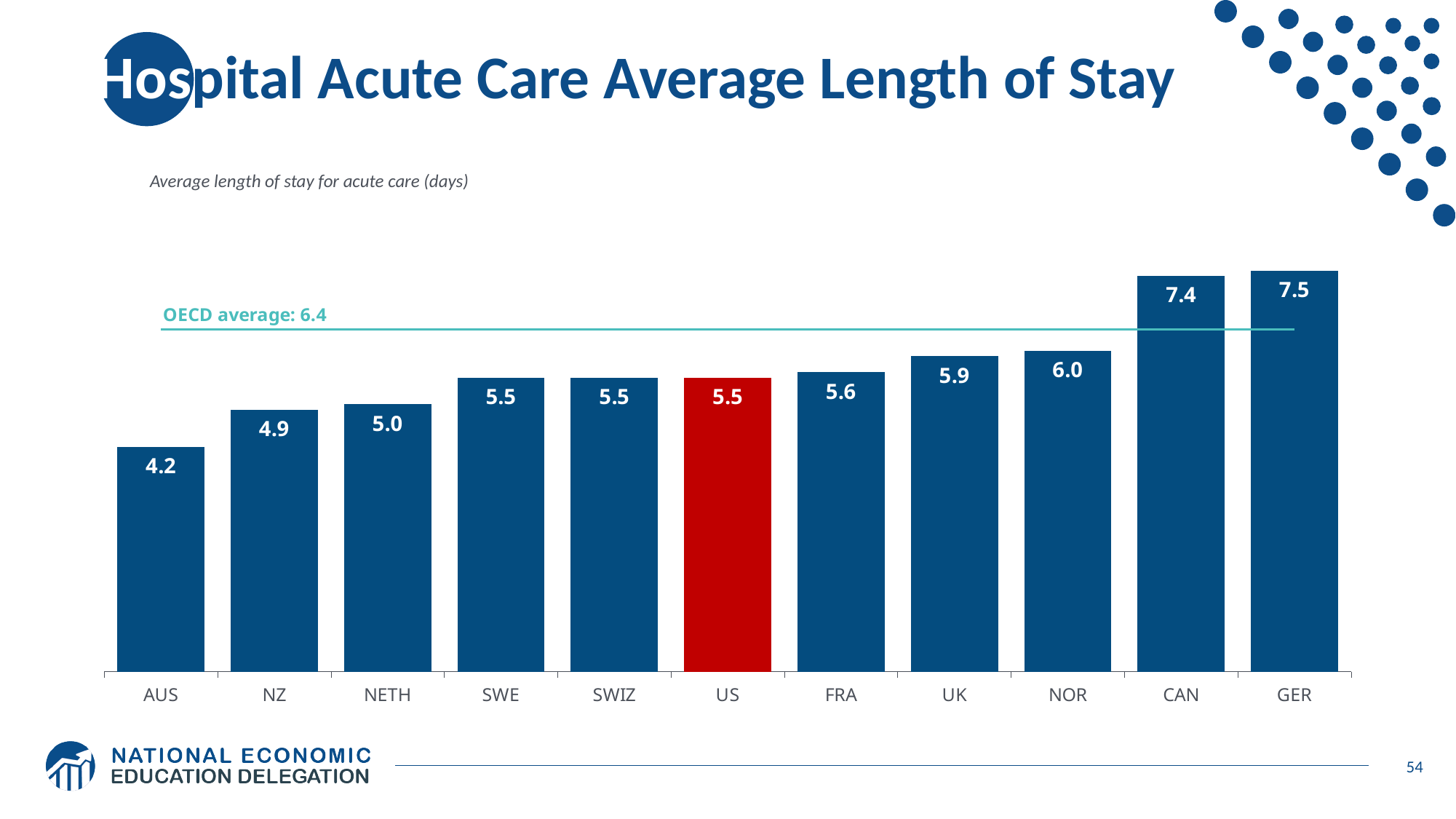
How many countries are shown in the chart? 11 Do the values generally rise or fall from left to right across the countries? Rise What is the average length of stay for acute care in Australia (AUS)? 4.2 Which country has the lowest average length of stay for acute care? AUS What is the average length of stay for acute care in Germany (GER)? 7.5 Which country has the highest average length of stay for acute care? GER What kind of chart is shown on the slide? Bar chart What is the difference in average length of stay between CAN and the US? 1.9 What is the difference in average length of stay between GER and AUS? 3.3 What is the average length of stay for acute care in the US? 5.5 Which has a longer average length of stay, NOR or NZ? NOR What is the OECD average length of stay shown by the horizontal line? 6.4